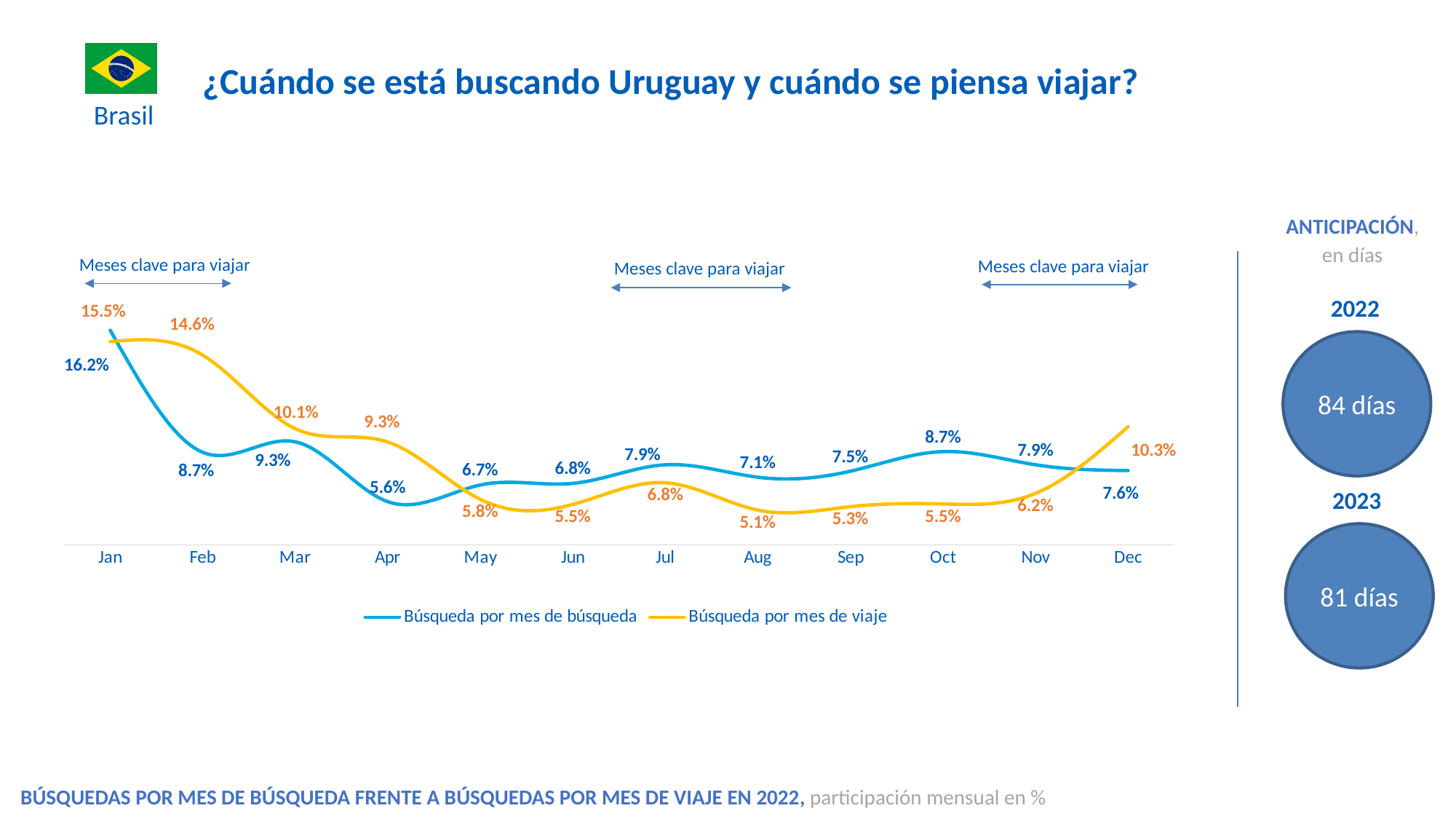
Which month has the lowest value for "Búsqueda por mes de búsqueda"? Apr What is the value of "Búsqueda por mes de viaje" for Dec? 10.3% How many series does the chart legend list? 2 How many months are shown on the x axis of the chart? 12 Which month has the highest value for "Búsqueda por mes de viaje"? Jan Which month has the lowest value for "Búsqueda por mes de viaje"? Aug In Dec, which series has the larger value: "Búsqueda por mes de búsqueda" or "Búsqueda por mes de viaje"? Búsqueda por mes de viaje What is the value of "Búsqueda por mes de búsqueda" for Jan? 16.2% What is the value of "Búsqueda por mes de viaje" for Feb? 14.6% What is the difference between "Búsqueda por mes de búsqueda" and "Búsqueda por mes de viaje" in Feb? 5.9% What kind of chart is shown on the slide? Line chart Does "Búsqueda por mes de viaje" rise or fall from Jan to Apr? Fall